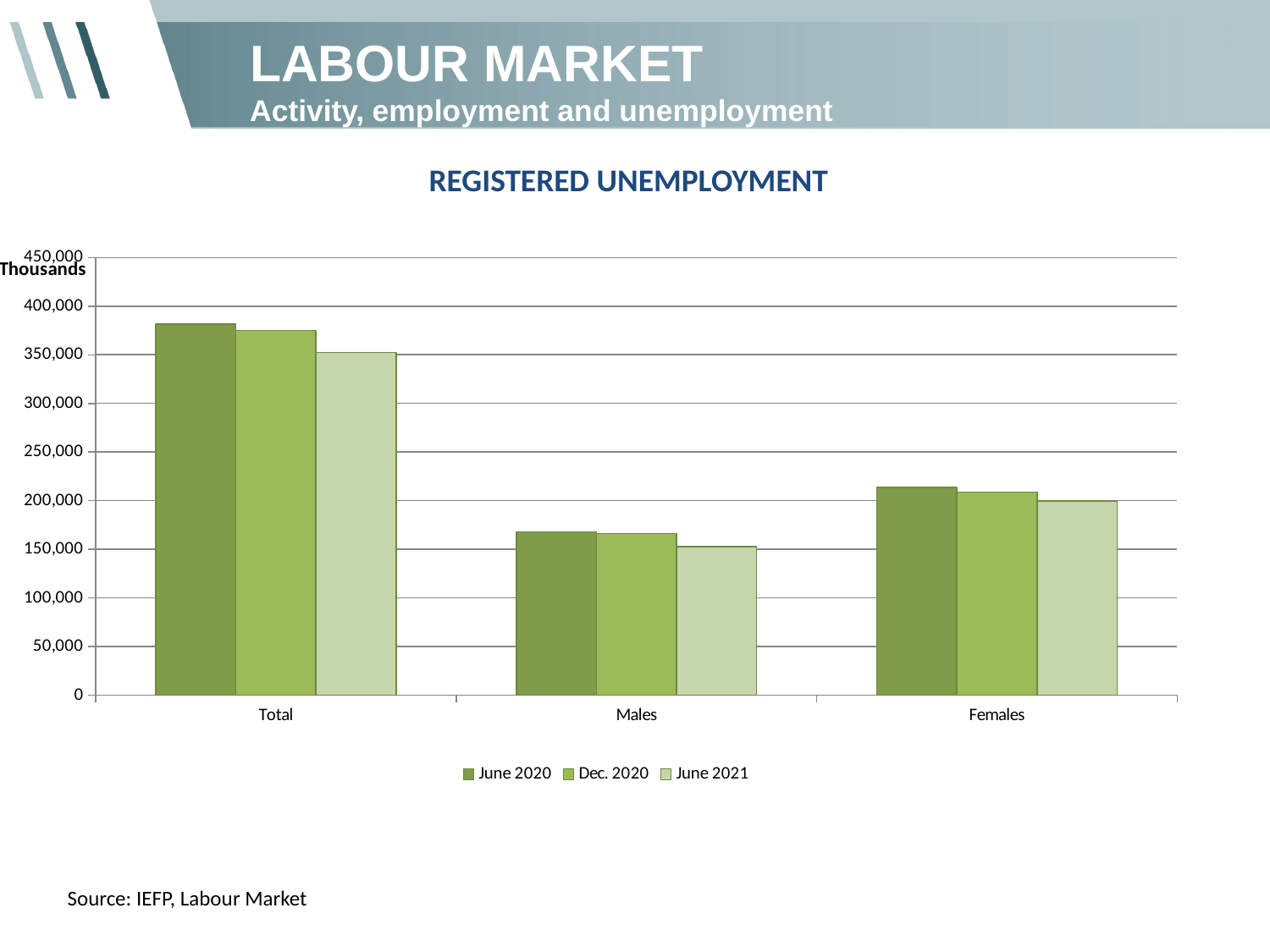
What kind of chart is shown on the slide? bar chart Which category has the highest registered unemployment in June 2020? Total Which is larger: the Total value for June 2020 or the Total value for June 2021? June 2020 Which category has the lowest registered unemployment in June 2021? Males Is the value for Total in Dec. 2020 greater or less than 400,000? less Which is larger: registered unemployment for Females in June 2020 or for Males in June 2020? Females in June 2020 Is the value for Males in June 2020 greater or less than 150,000? greater Is the value for Females in June 2020 greater or less than 200,000? greater How many categories are shown on the x axis of the chart? 3 Do the values for Total rise or fall from June 2020 to June 2021? fall How many series does the legend list? 3